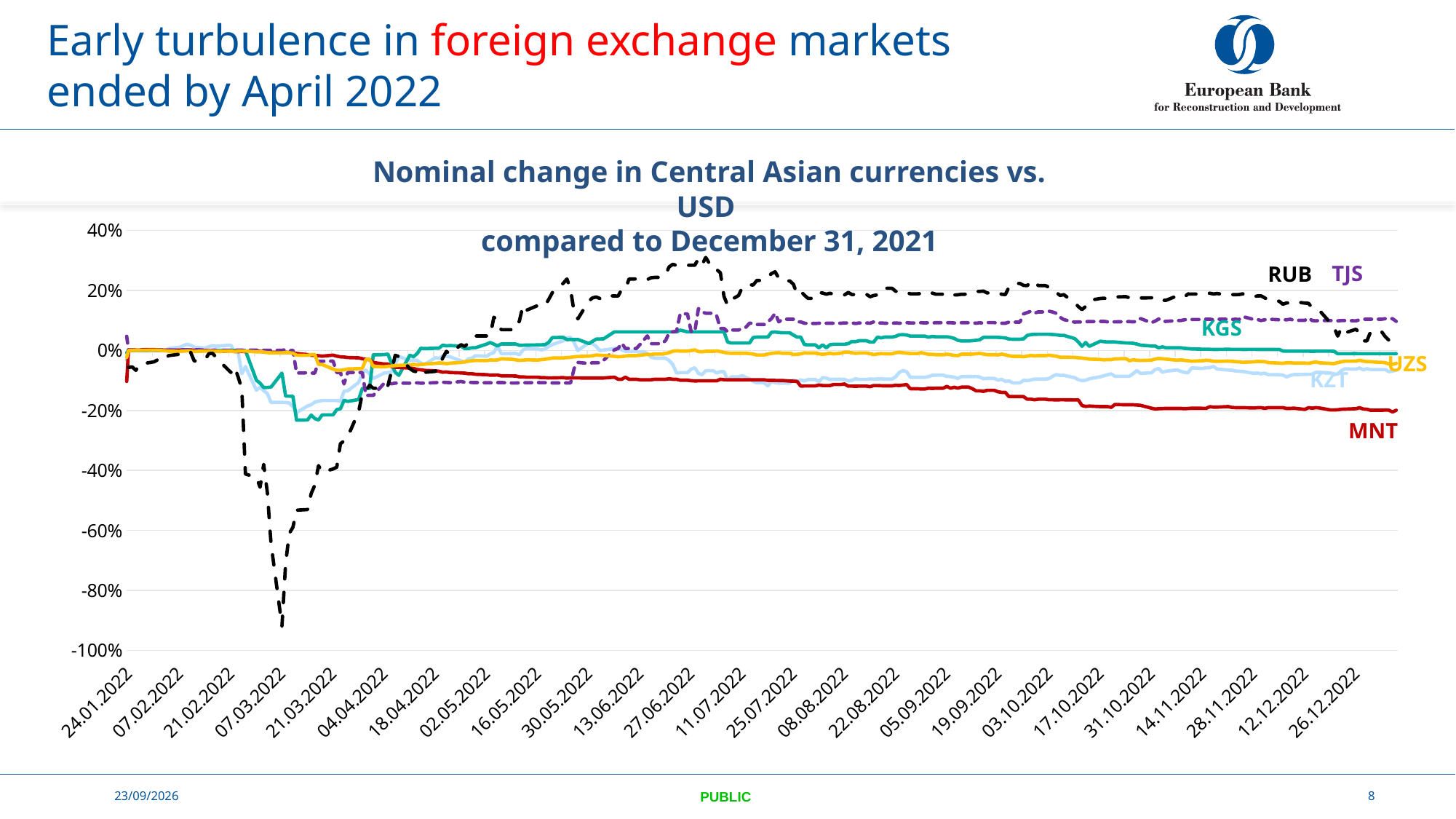
Is the lowest point of the RUB series greater or less than -80%? less Which currency series is the lowest at the end of the chart (26.12.2022)? MNT Which currency series reaches the lowest value on the chart? RUB Which currency series is drawn as a black dashed line? RUB At the end of the chart, which is higher: TJS or MNT? TJS Is the value for MNT at the end of the chart greater or less than -10%? less How many currency series are plotted on the chart? 6 How many date labels are shown on the x axis? 25 What kind of chart is shown on the slide? line chart What is the title of the chart? Nominal change in Central Asian currencies vs. USD compared to December 31, 2021 Is the highest point of the RUB series greater or less than 20%? greater Does the MNT series generally rise or fall over the course of 2022? fall